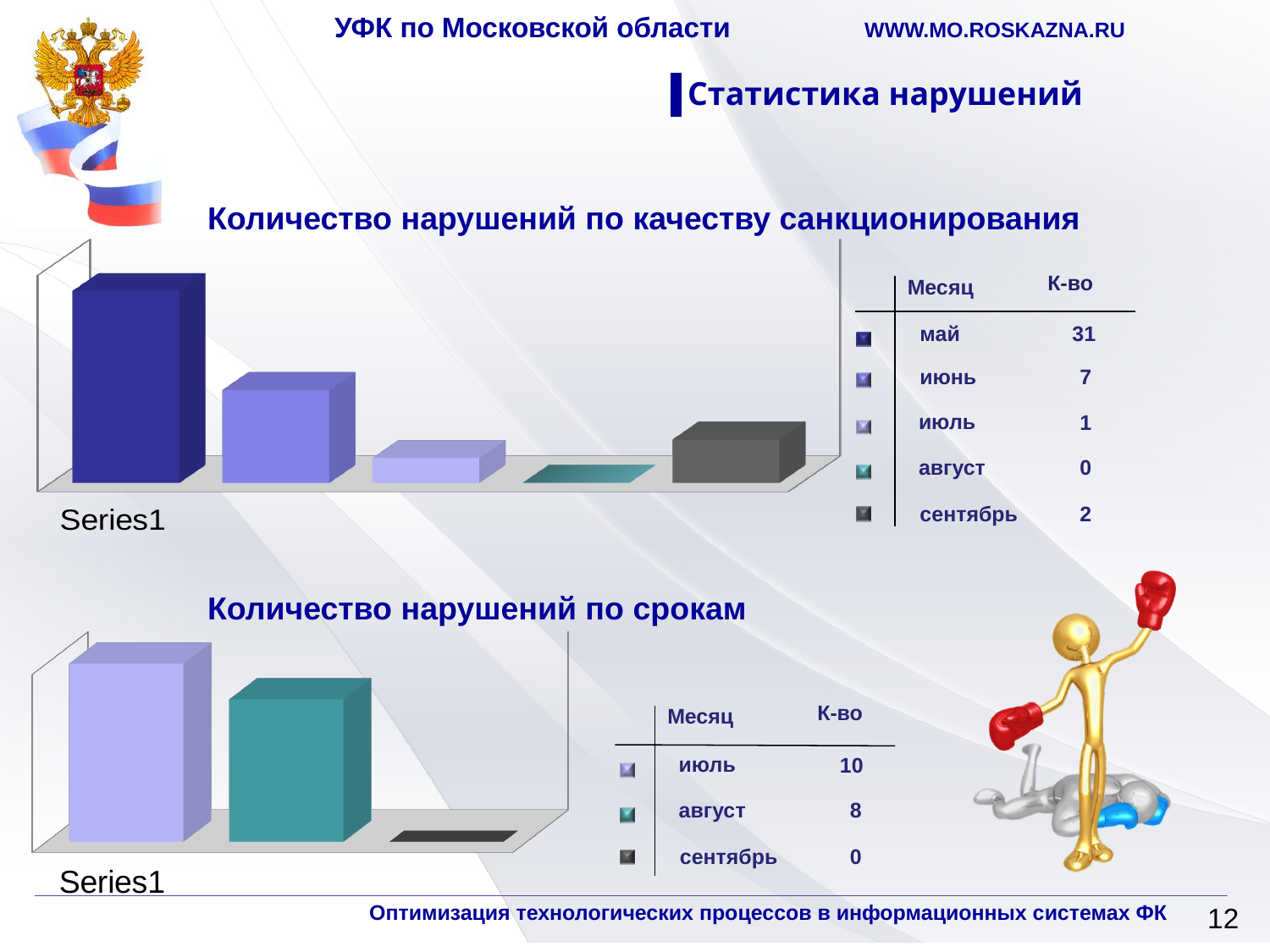
On the chart 'Количество нарушений по срокам', what is the value for июль? 10 What type of chart is 'Количество нарушений по срокам'? bar chart On the chart 'Количество нарушений по качеству санкционирования', how many months are shown? 5 On the chart 'Количество нарушений по качеству санкционирования', what is the difference between the values for май and июнь? 24 On the chart 'Количество нарушений по срокам', how many months are shown? 3 On the chart 'Количество нарушений по качеству санкционирования', what is the value for май? 31 On the chart 'Количество нарушений по качеству санкционирования', what is the value for июнь? 7 On the chart 'Количество нарушений по качеству санкционирования', which month has the highest value? май On the chart 'Количество нарушений по срокам', which is larger, the value for июль or the value for август? июль On the chart 'Количество нарушений по качеству санкционирования', which month has the lowest value? август On the chart 'Количество нарушений по срокам', what is the value for сентябрь? 0 On the chart 'Количество нарушений по срокам', what is the difference between the values for июль and август? 2